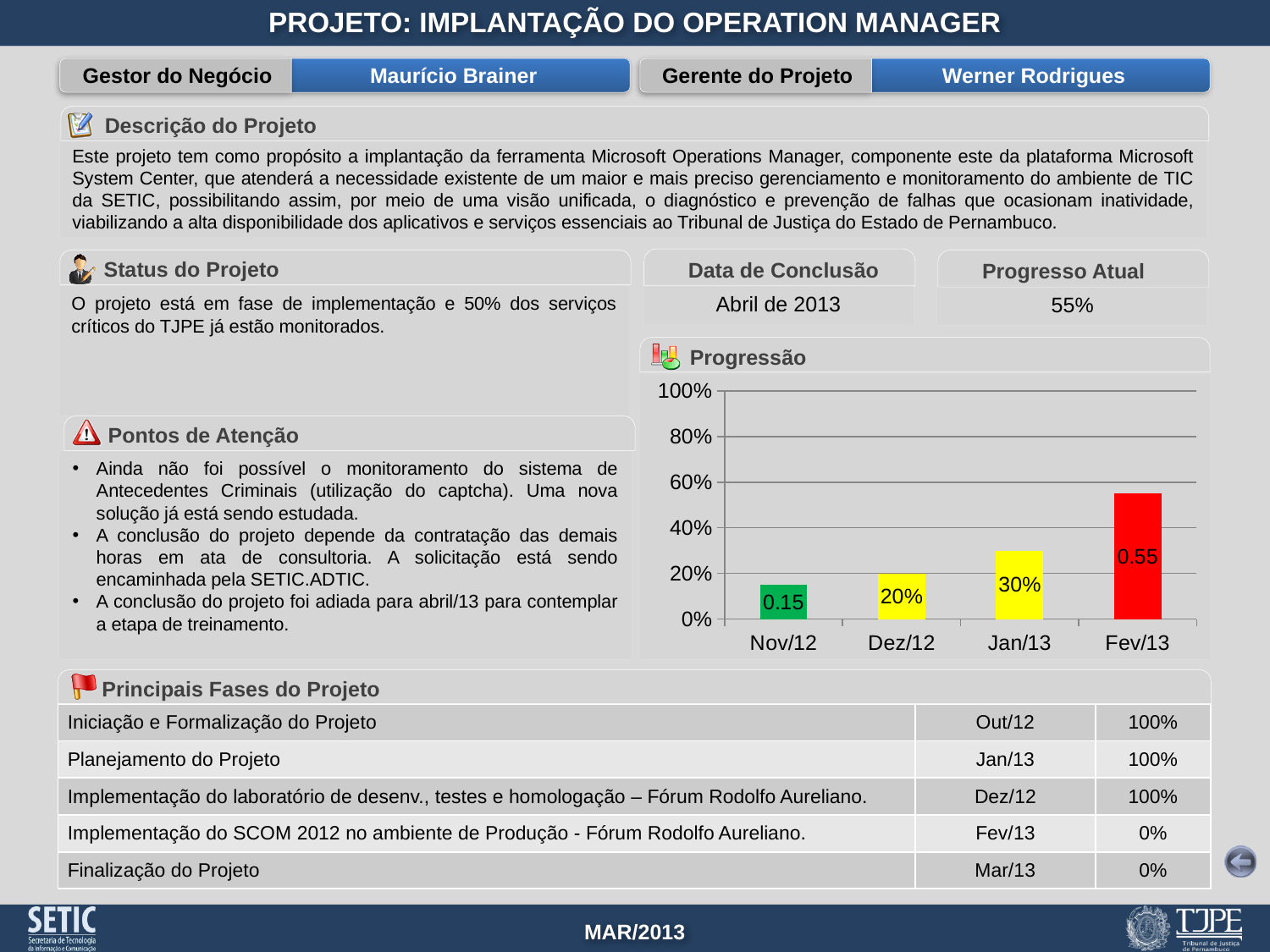
What is the value labelled on the bar for Nov/12 in the Progressão chart? 0.15 What is the value labelled on the bar for Jan/13 in the Progressão chart? 30% In the Progressão chart, is the value for Fev/13 greater or less than 40%? greater How many categories are shown on the x axis of the Progressão chart? 4 Which month has the lowest bar in the Progressão chart? Nov/12 What is the value labelled on the bar for Dez/12 in the Progressão chart? 20% Do the values in the Progressão chart rise or fall from Nov/12 to Fev/13? rise Which month has the highest bar in the Progressão chart? Fev/13 What is the title of the chart on the slide? Progressão What kind of chart is shown under "Progressão"? bar chart What is the value labelled on the bar for Fev/13 in the Progressão chart? 0.55 In the Progressão chart, what is the difference between the values for Jan/13 and Dez/12? 10%